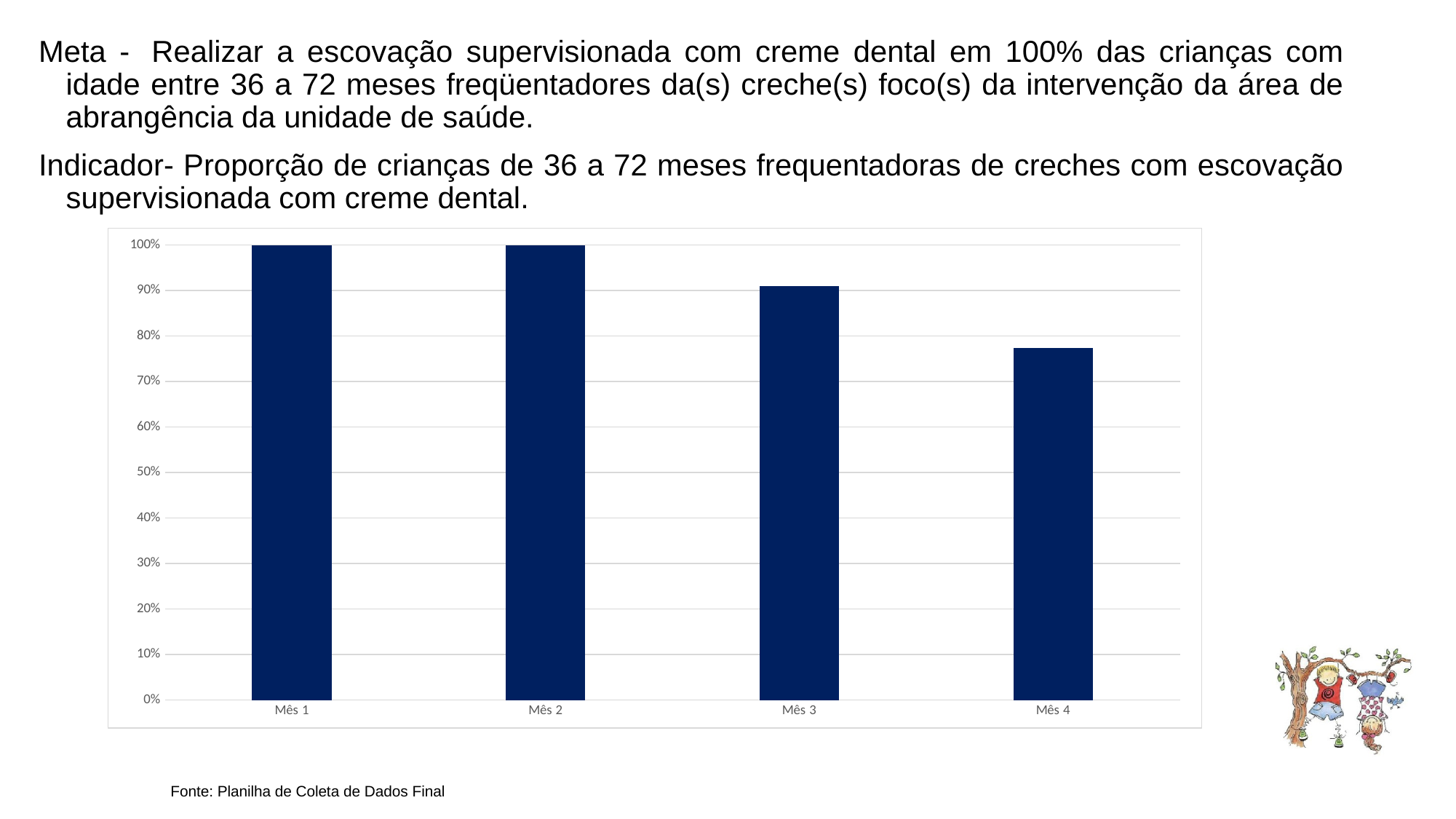
Do the values rise or fall from Mês 2 to Mês 4? fall Which is larger, the value for Mês 2 or the value for Mês 4? Mês 2 Is the value for Mês 3 greater or less than 100%? less What kind of chart is shown on the slide? bar chart How many categories (months) are plotted on the chart? 4 Is the value for Mês 3 greater or less than 80%? greater Is the value for Mês 4 greater or less than 80%? less What is the value for Mês 1? 100% What is the value for Mês 2? 100% What source is cited below the chart? Planilha de Coleta de Dados Final Which month has the lowest value? Mês 4